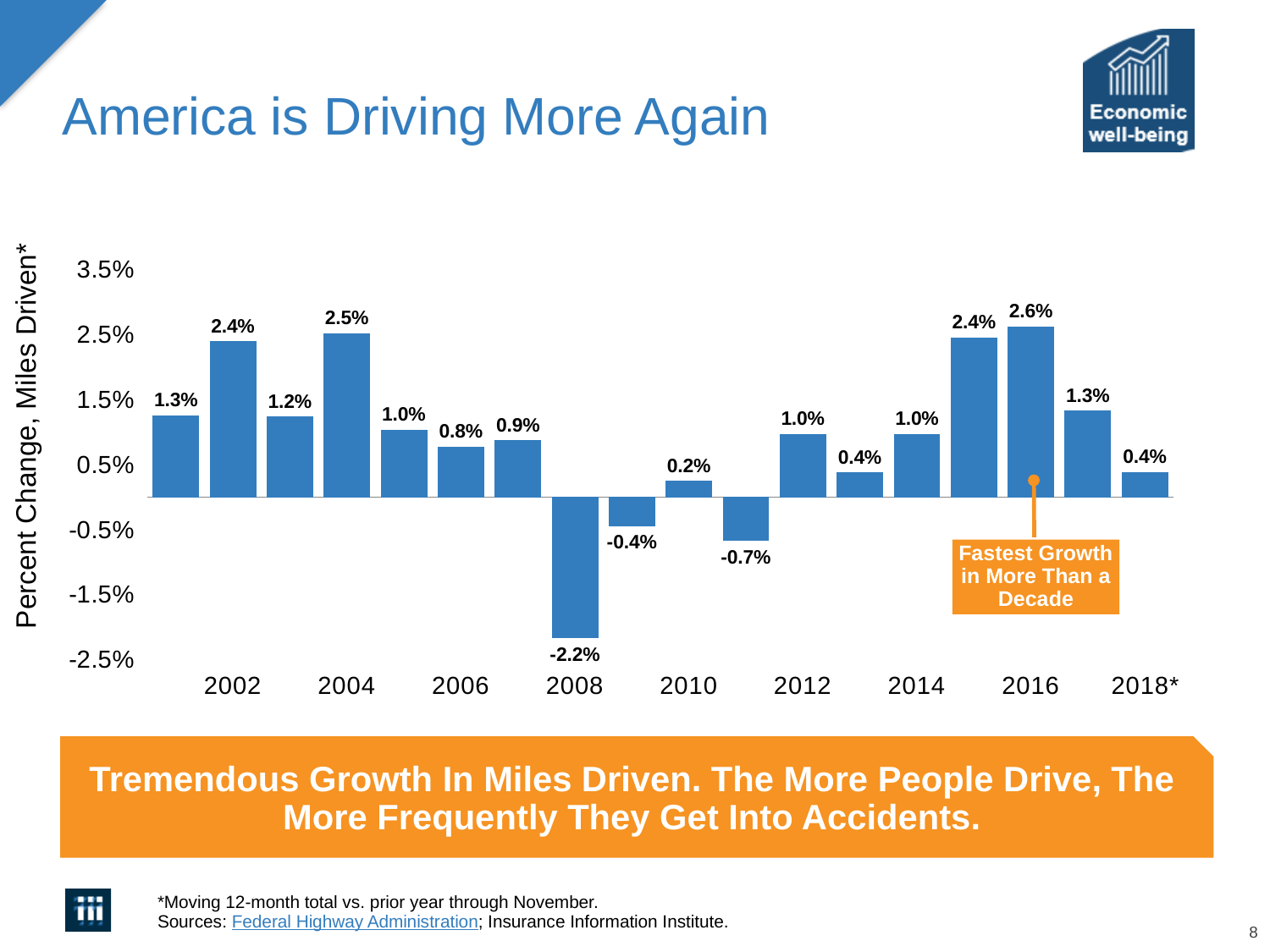
How many bars are plotted in the chart? 18 What is the percent change in miles driven for 2004? 2.5% What does the callout box on the chart say about the 2016 bar? Fastest Growth in More Than a Decade Which year has the highest percent change in miles driven? 2016 What kind of chart is shown on the slide? Bar chart Which year has the lowest percent change in miles driven? 2008 Which year has a larger percent change in miles driven, 2002 or 2010? 2002 What is the difference between the percent change in 2016 and the percent change in 2018*? 2.2% Is the value for 2012 greater or less than 0.5%? greater What is the percent change in miles driven for 2008? -2.2% What is the percent change in miles driven for 2016? 2.6% What is the percent change in miles driven for 2018*? 0.4%